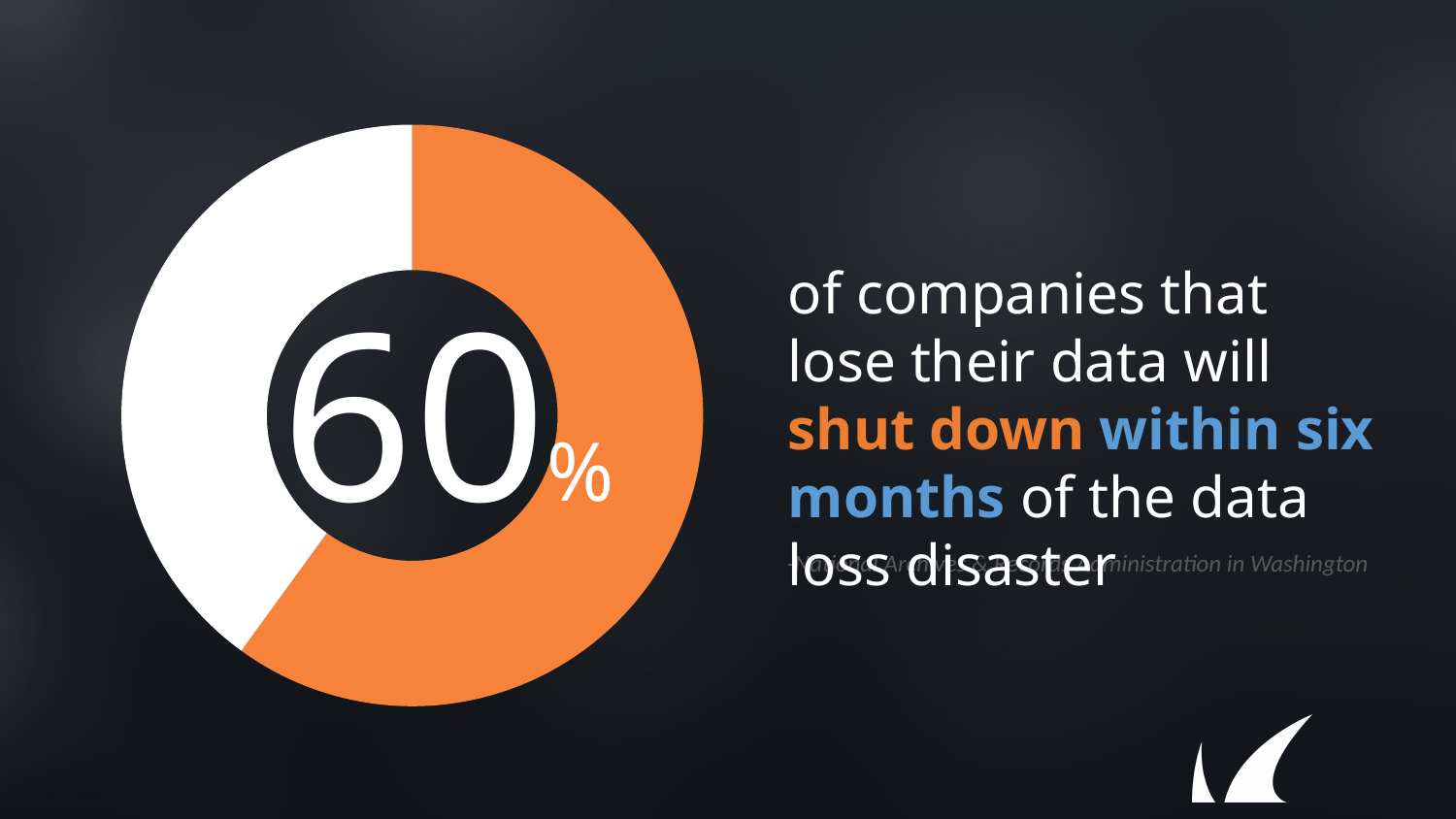
What share of the donut chart does the orange segment represent? 60% How many segments does the donut chart have? 2 What kind of chart is shown on the slide? Donut (pie) chart According to the slide, what percentage of companies that lose their data will shut down within six months? 60% What share of the donut chart does the white segment represent? 40% What two colours are used for the segments of the donut chart? Orange and white Which segment of the donut chart is larger, the orange one or the white one? Orange Is the orange segment's share of the donut chart greater or less than 50%? greater What colour is the larger segment of the donut chart? Orange What percentage is shown in the centre of the donut chart? 60%